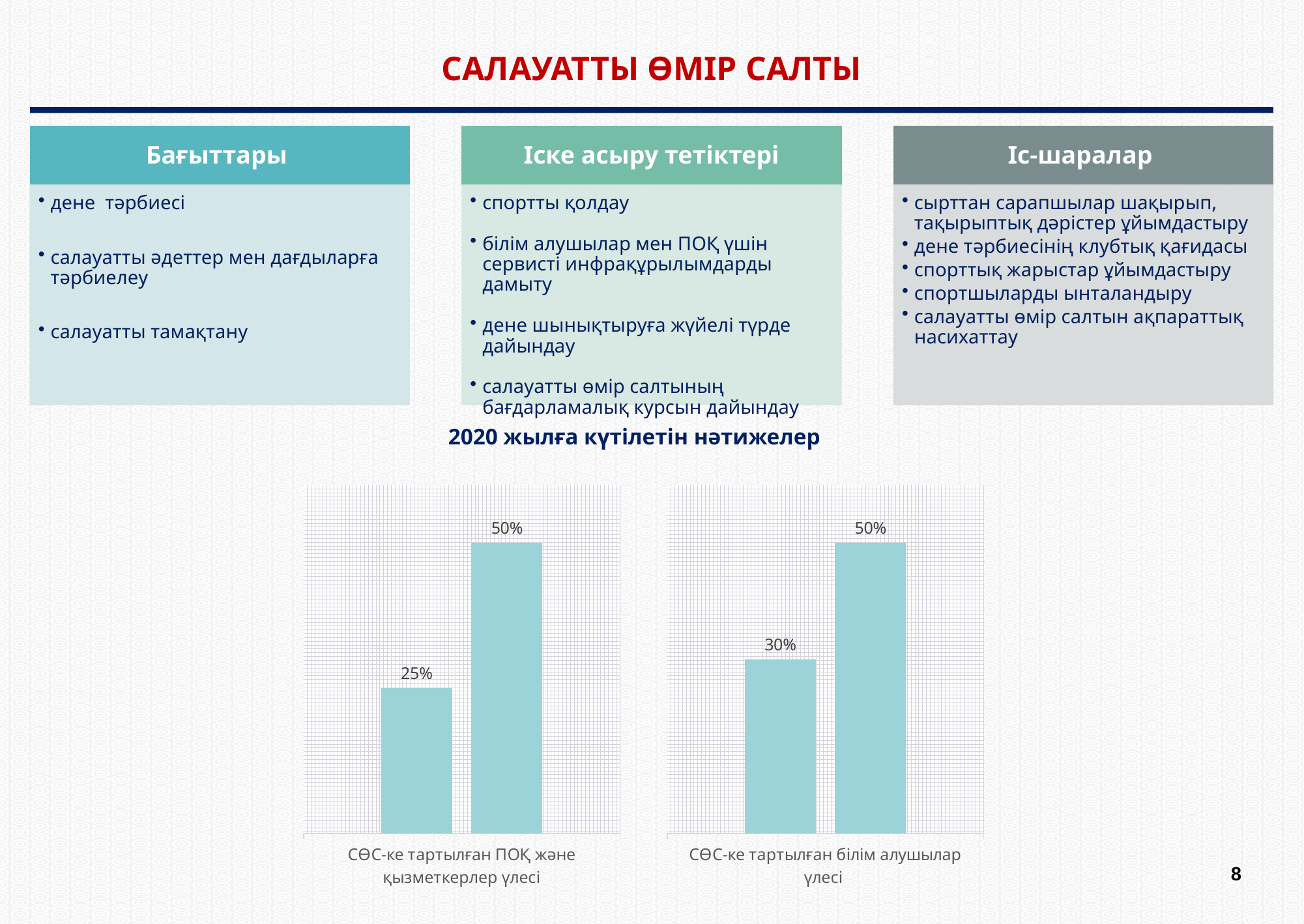
Which is larger: the first bar of the left chart (25%) or the first bar of the right chart (30%)? the first bar of the right chart (30%) In the left chart (СӨС-ке тартылған ПОҚ және қызметкерлер үлесі), what is the value of the first (left) bar? 25% Do the values in the left chart (СӨС-ке тартылған ПОҚ және қызметкерлер үлесі) rise or fall from the first bar to the second? rise In the left chart (СӨС-ке тартылған ПОҚ және қызметкерлер үлесі), what is the value of the second (right) bar? 50% In the right chart (СӨС-ке тартылған білім алушылар үлесі), what is the value of the second (right) bar? 50% What type of chart is the right chart (СӨС-ке тартылған білім алушылар үлесі)? bar chart In the right chart (СӨС-ке тартылған білім алушылар үлесі), what is the value of the first (left) bar? 30% In the left chart (СӨС-ке тартылған ПОҚ және қызметкерлер үлесі), which bar is higher, the first or the second? the second In the left chart (СӨС-ке тартылған ПОҚ және қызметкерлер үлесі), what is the difference between the two bars? 25% In the right chart (СӨС-ке тартылған білім алушылар үлесі), what is the difference between the two bars? 20% How many bars does the left chart (СӨС-ке тартылған ПОҚ және қызметкерлер үлесі) show? 2 How many bars does the right chart (СӨС-ке тартылған білім алушылар үлесі) show? 2